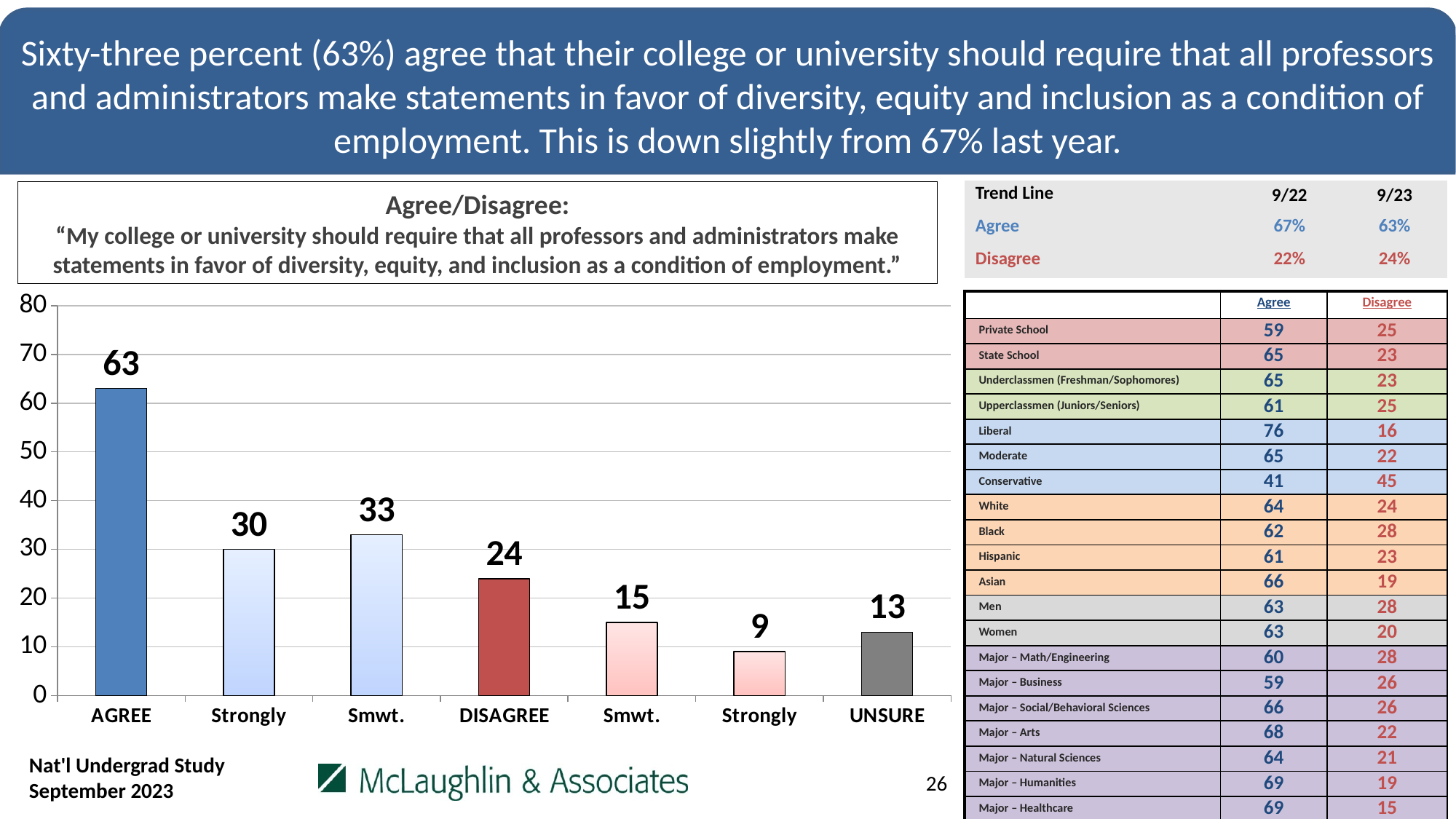
What is the value of the Strongly bar immediately to the left of UNSURE (strongly disagree)? 9 Which category has the lowest bar? Strongly (strongly disagree) What is the value of the AGREE bar? 63 What is the value of the DISAGREE bar? 24 How many bars are shown in the chart? 7 What is the maximum value shown on the chart's vertical axis? 80 What type of chart is shown on the slide? Bar chart Which category has the highest bar? AGREE What is the difference between the AGREE bar and the DISAGREE bar? 39 What is the value of the Strongly bar immediately to the right of AGREE (strongly agree)? 30 Which is larger, the Smwt. bar next to AGREE (somewhat agree) or the Smwt. bar next to DISAGREE (somewhat disagree)? Smwt. next to AGREE (somewhat agree), 33 What is the value of the UNSURE bar? 13